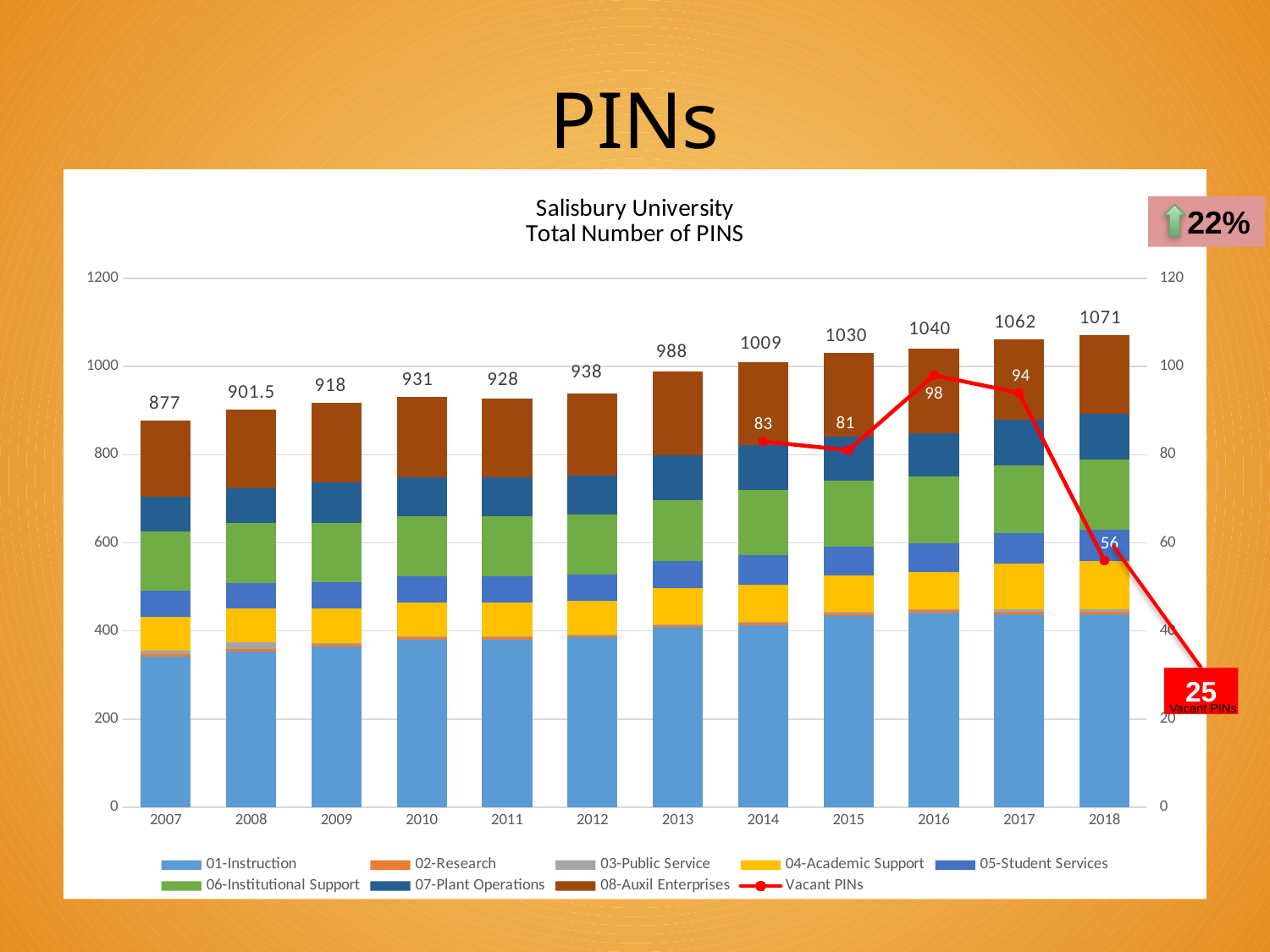
What is the total number of PINs shown for 2018? 1071 Is the 01-Instruction value for 2018 greater or less than 400? greater How many series does the legend list? 9 Which year has the highest total number of PINs? 2018 What is the total number of PINs shown for 2007? 877 Which year has the lowest total number of PINs? 2007 By how much did the total number of PINs increase from 2007 to 2018? 194 What is the difference between the Vacant PINs values for 2016 and 2015? 17 What is the total number of PINs shown for 2008? 901.5 How many years are shown on the x axis? 12 Which year has a larger total number of PINs, 2010 or 2011? 2010 What is the value of Vacant PINs for 2016? 98